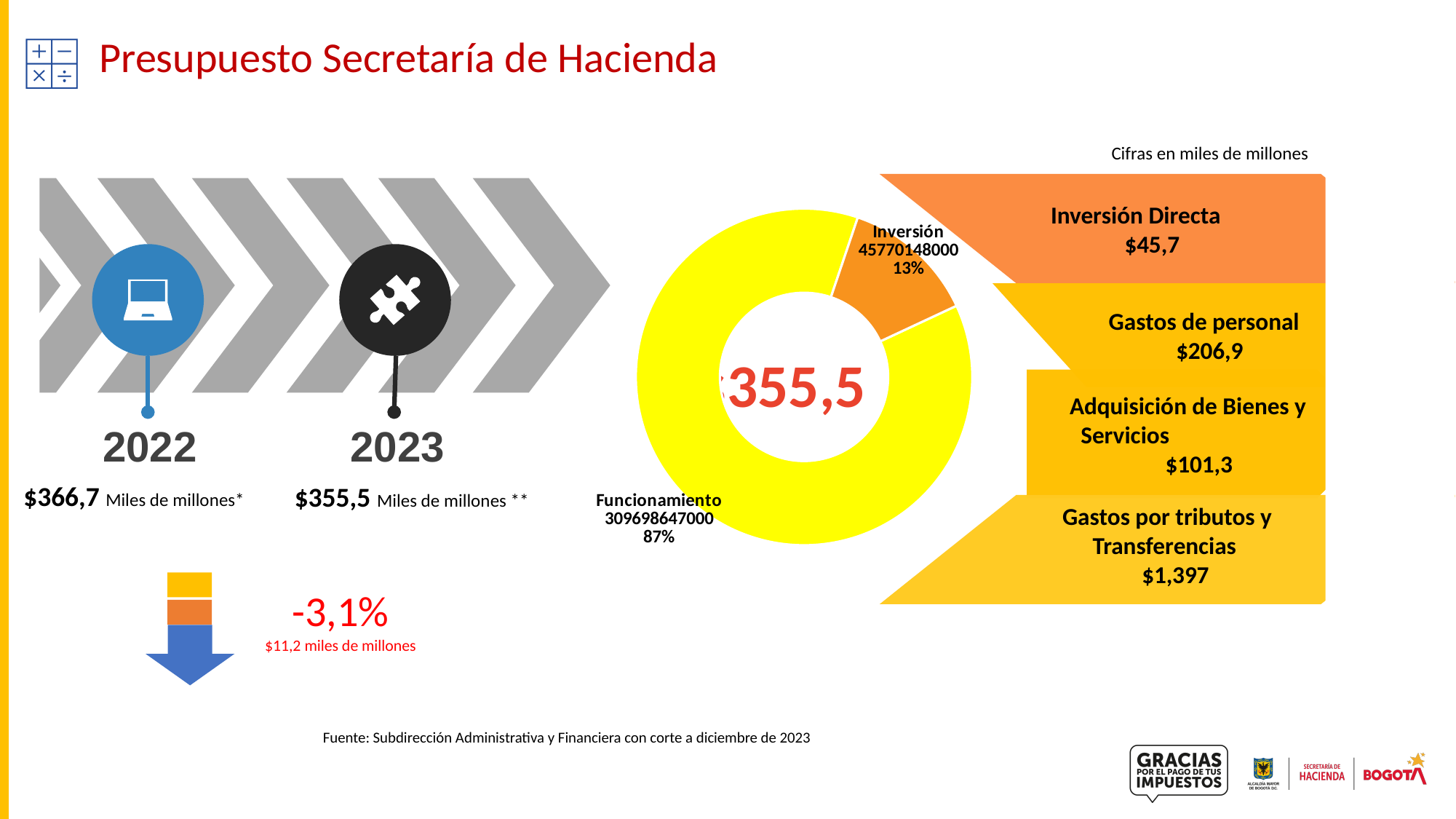
What value is shown for Funcionamiento in the doughnut chart? 309698647000 What percentage share does Funcionamiento have in the doughnut chart? 87% Which is larger in the doughnut chart, Funcionamiento or Inversión? Funcionamiento Which slice of the doughnut chart is the smallest? Inversión What is the difference in percentage points between the Funcionamiento share and the Inversión share in the doughnut chart? 74 What value is shown for Inversión in the doughnut chart? 45770148000 Which slice of the doughnut chart is the largest? Funcionamiento How many slices does the doughnut chart have? 2 What kind of chart is shown in the middle of the slide? Doughnut (pie) chart What colour is the Inversión slice in the doughnut chart? Orange What percentage share does Inversión have in the doughnut chart? 13% What number is displayed in the centre of the doughnut chart? 355,5